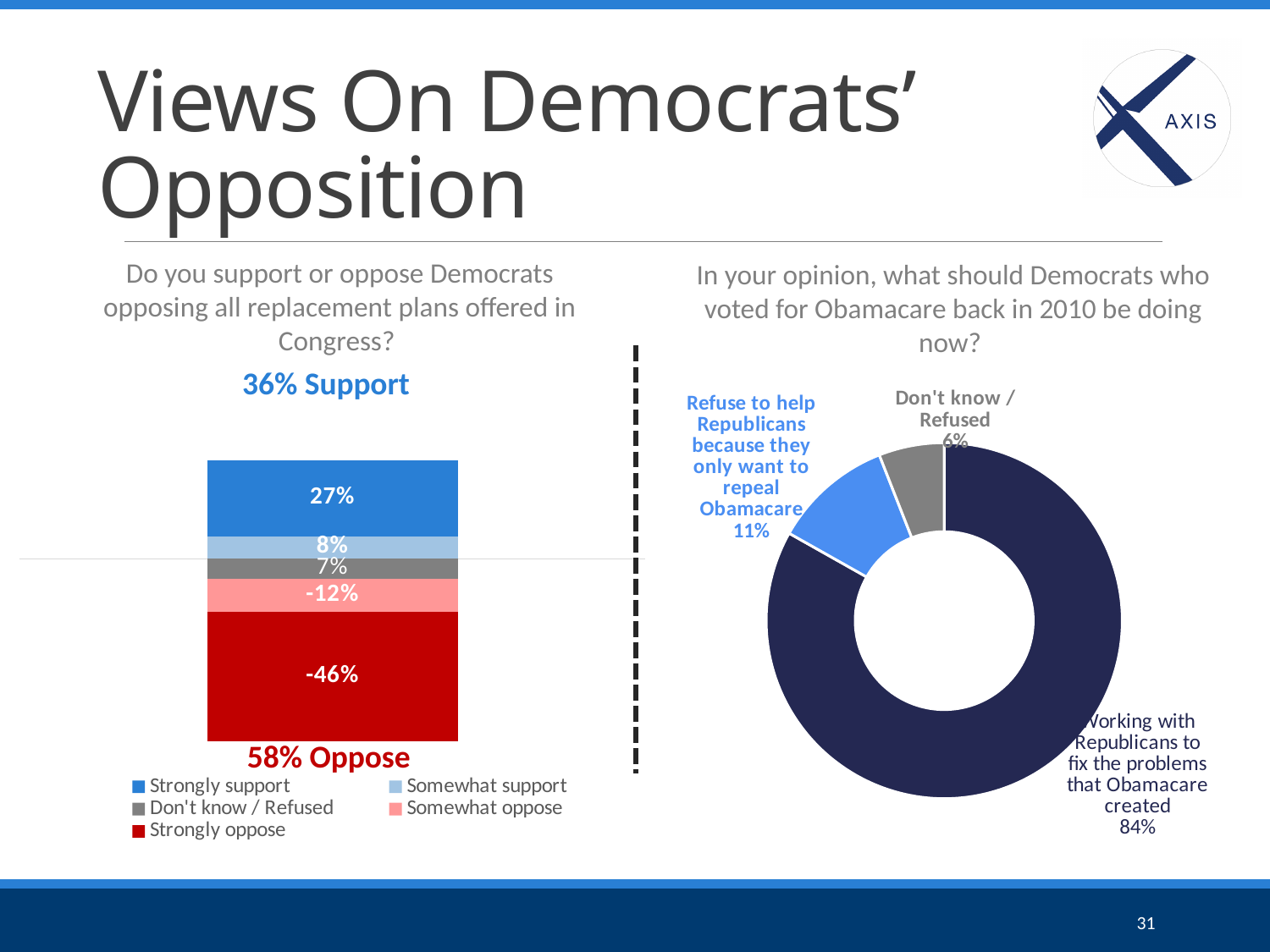
On the left chart (Do you support or oppose Democrats opposing all replacement plans offered in Congress?), what kind of chart is it? Stacked bar chart On the left chart (Do you support or oppose Democrats opposing all replacement plans offered in Congress?), what is the value for Somewhat oppose? -12% On the right chart (In your opinion, what should Democrats who voted for Obamacare back in 2010 be doing now?), how many categories are shown? 3 On the left chart (Do you support or oppose Democrats opposing all replacement plans offered in Congress?), which is larger in magnitude: Strongly support or Strongly oppose? Strongly oppose On the right chart (In your opinion, what should Democrats who voted for Obamacare back in 2010 be doing now?), what share is Working with Republicans to fix the problems that Obamacare created? 84% On the left chart (Do you support or oppose Democrats opposing all replacement plans offered in Congress?), how many series does the legend list? 5 On the left chart (Do you support or oppose Democrats opposing all replacement plans offered in Congress?), what total percentage is labelled as Support? 36% Support On the right chart (In your opinion, what should Democrats who voted for Obamacare back in 2010 be doing now?), what share is Refuse to help Republicans because they only want to repeal Obamacare? 11% On the right chart (In your opinion, what should Democrats who voted for Obamacare back in 2010 be doing now?), what is the difference between the Working with Republicans share and the Refuse to help Republicans share? 73% On the left chart (Do you support or oppose Democrats opposing all replacement plans offered in Congress?), what is the value for Strongly support? 27% On the right chart (In your opinion, what should Democrats who voted for Obamacare back in 2010 be doing now?), which category is the smallest? Don't know / Refused On the left chart (Do you support or oppose Democrats opposing all replacement plans offered in Congress?), what is the value for Strongly oppose? -46%